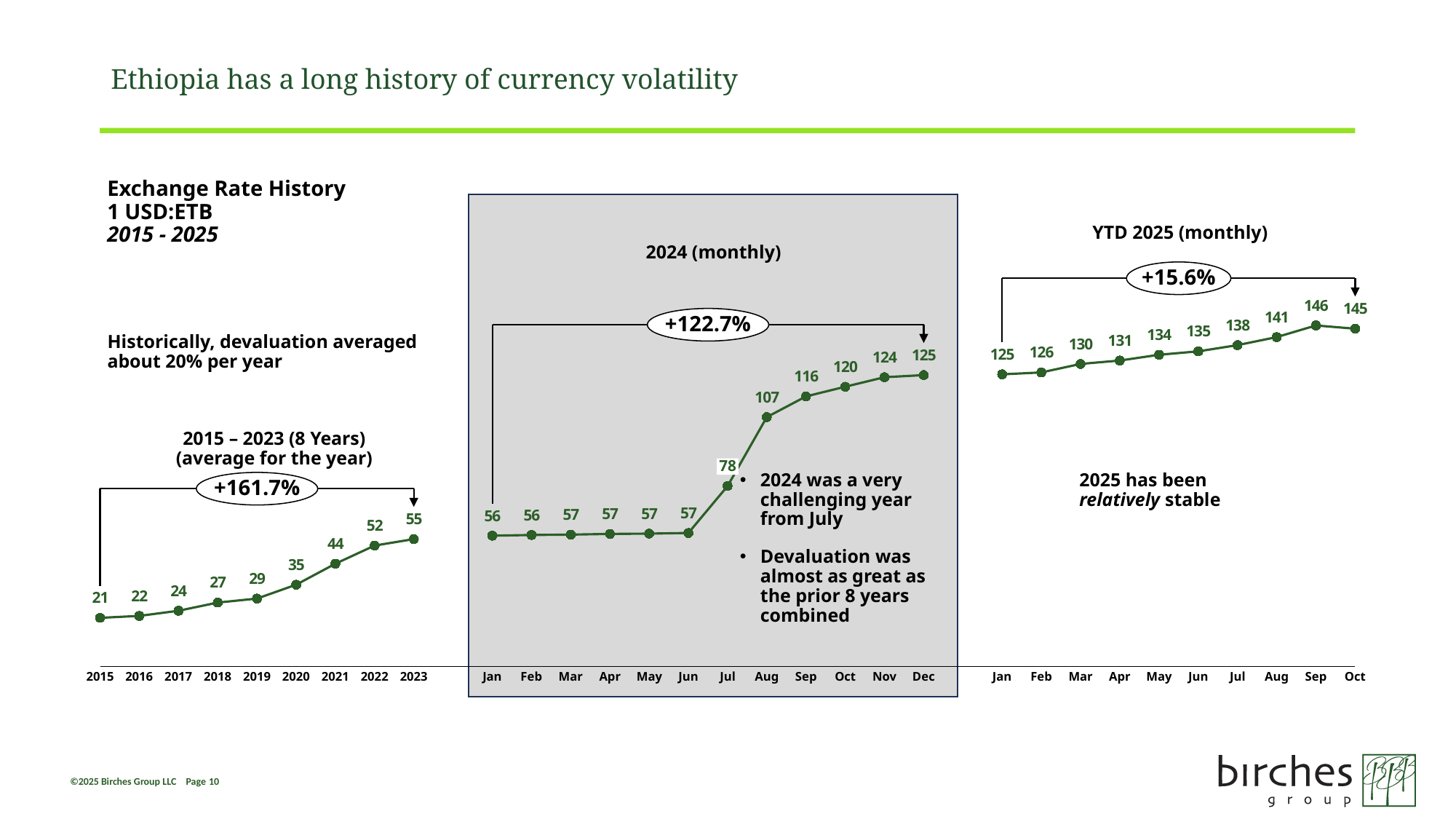
In the YTD 2025 (monthly) chart, what is the value for Jun? 135 What kind of chart is the YTD 2025 (monthly) chart? Line chart In the 2024 (monthly) chart, which month has the highest value? Dec In the YTD 2025 (monthly) chart, is the value for Sep or Oct larger? Sep In the 2024 (monthly) chart, what is the value for Aug? 107 In the 2015 – 2023 (average for the year) chart, what is the difference between the 2023 value and the 2015 value? 34 In the 2015 – 2023 (average for the year) chart, how many years are plotted? 9 In the 2024 (monthly) chart, what is the difference between the Jul value and the Jun value? 21 In the 2024 (monthly) chart, what percentage change is shown in the oval annotation? +122.7% In the 2015 – 2023 (average for the year) chart, what is the value for 2020? 35 In the 2015 – 2023 (average for the year) chart, which year has the highest value? 2023 In the YTD 2025 (monthly) chart, which month has the highest value? Sep